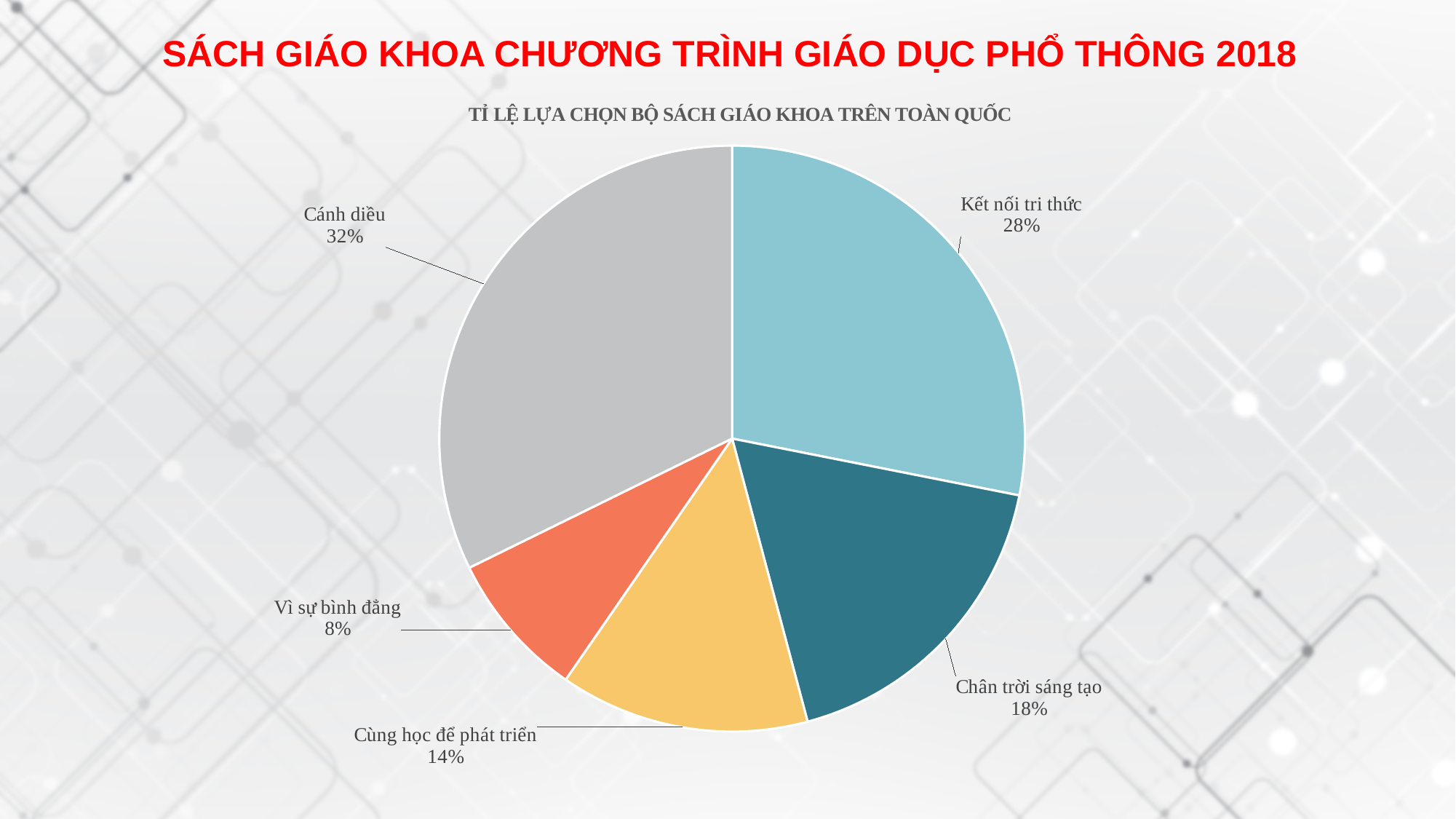
What percentage is shown for Chân trời sáng tạo? 18% Which textbook set has the largest share of the pie? Cánh diều What type of chart is shown on the slide? pie chart What is the title of the chart? TỈ LỆ LỰA CHỌN BỘ SÁCH GIÁO KHOA TRÊN TOÀN QUỐC How many slices does the pie chart have? 5 What percentage is shown for Cánh diều? 32% What percentage is shown for Kết nối tri thức? 28% Which textbook set has the smallest share of the pie? Vì sự bình đẳng What is the difference in percentage points between Cánh diều and Kết nối tri thức? 4 What percentage is shown for Vì sự bình đẳng? 8% Which has a larger share, Chân trời sáng tạo or Cùng học để phát triển? Chân trời sáng tạo What percentage is shown for Cùng học để phát triển? 14%